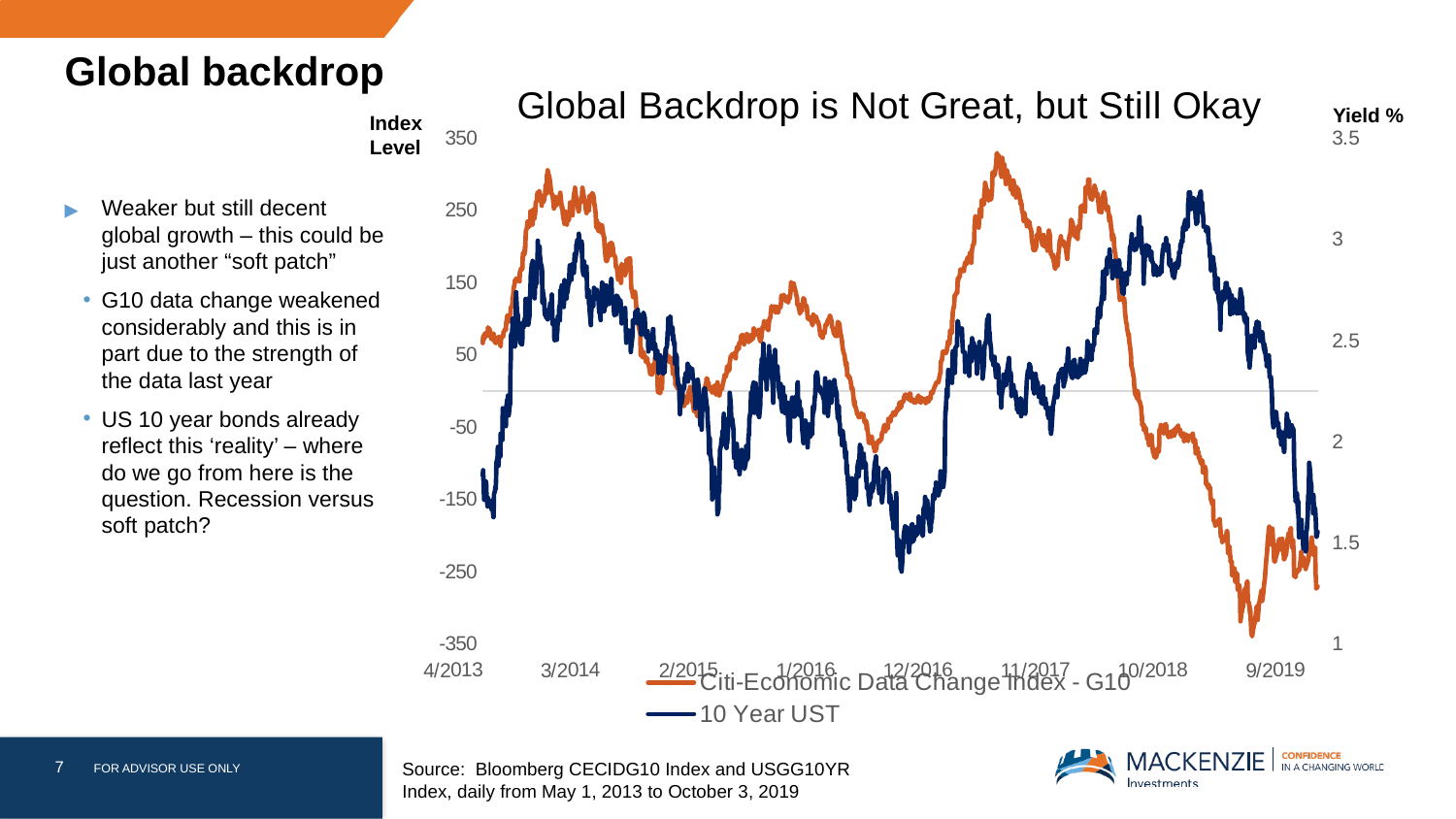
How many series does the chart's legend list? 2 How many date labels are shown along the x axis of the chart? 8 What is the highest value shown on the left-hand vertical axis of the chart? 350 What kind of chart is shown on the slide? Line chart What is the label of the right-hand vertical axis of the chart? Yield % Is the final value of the Citi-Economic Data Change Index - G10 at the right end of the chart greater or less than -150? less Does the Citi-Economic Data Change Index - G10 rise or fall between 11/2017 and 9/2019? fall What is the title of the chart? Global Backdrop is Not Great, but Still Okay Is the peak value of the Citi-Economic Data Change Index - G10 near 11/2017 greater or less than 250? greater Is the peak value of the 10 Year UST near 10/2018 greater or less than 3? greater Does the 10 Year UST rise or fall between 10/2018 and 9/2019? fall